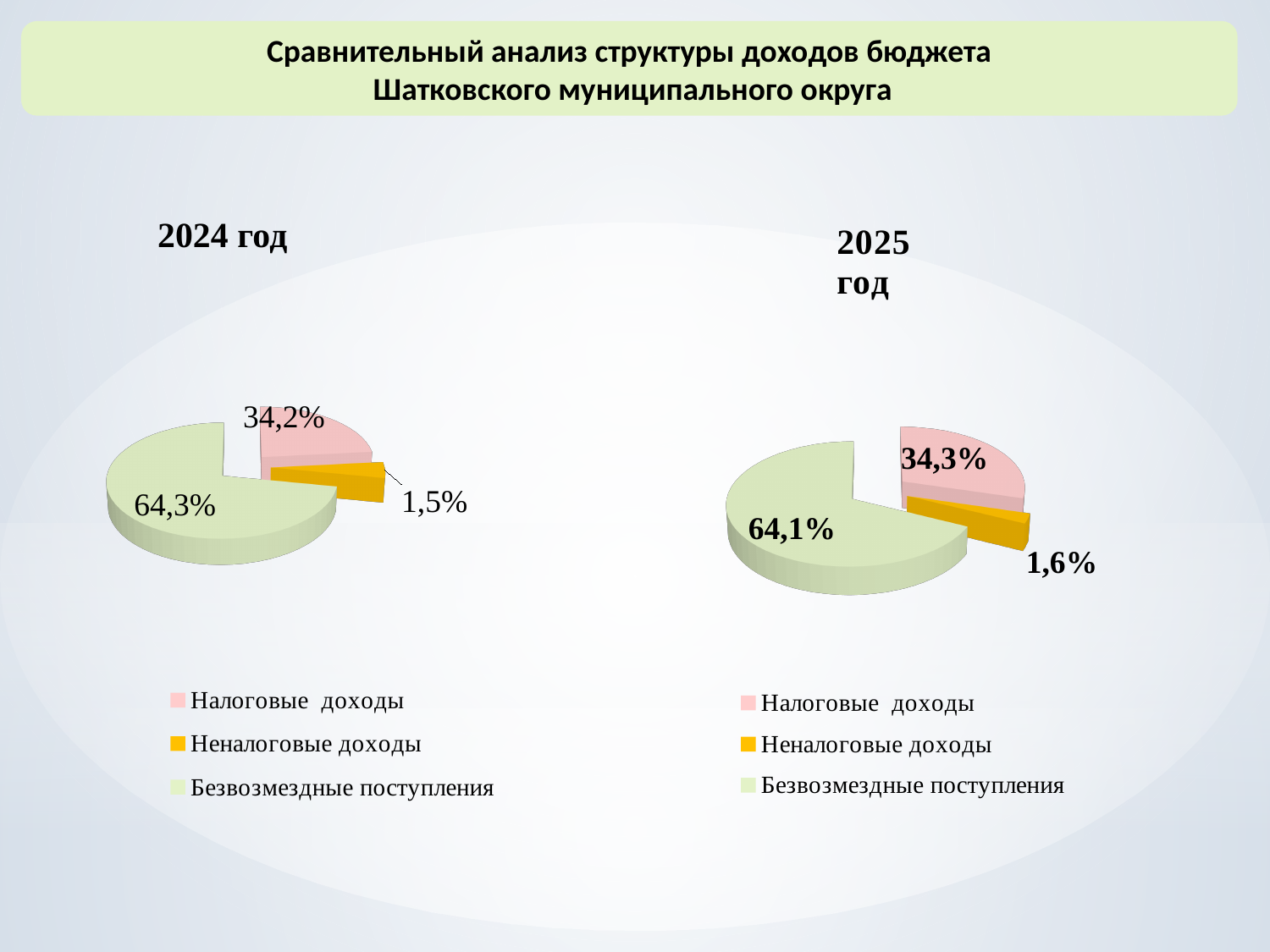
In the 2024 год chart, what share is shown for Неналоговые доходы? 1,5% In the 2024 год chart, what share is shown for Налоговые доходы? 34,2% In the 2025 год chart, which category has the smallest slice? Неналоговые доходы In the 2025 год chart, what share is shown for Неналоговые доходы? 1,6% How many categories does the 2025 год chart show? 3 In the 2024 год chart, what is the difference between the shares of Безвозмездные поступления and Налоговые доходы? 30,1% What type of chart is the 2024 год chart? Pie chart How many entries does the legend of the 2024 год chart list? 3 In the 2025 год chart, what share is shown for Безвозмездные поступления? 64,1% In the 2025 год chart, what colour is the slice for Неналоговые доходы? Orange Which is larger: Налоговые доходы in the 2024 год chart or Налоговые доходы in the 2025 год chart? 2025 год In the 2024 год chart, which category has the largest slice? Безвозмездные поступления